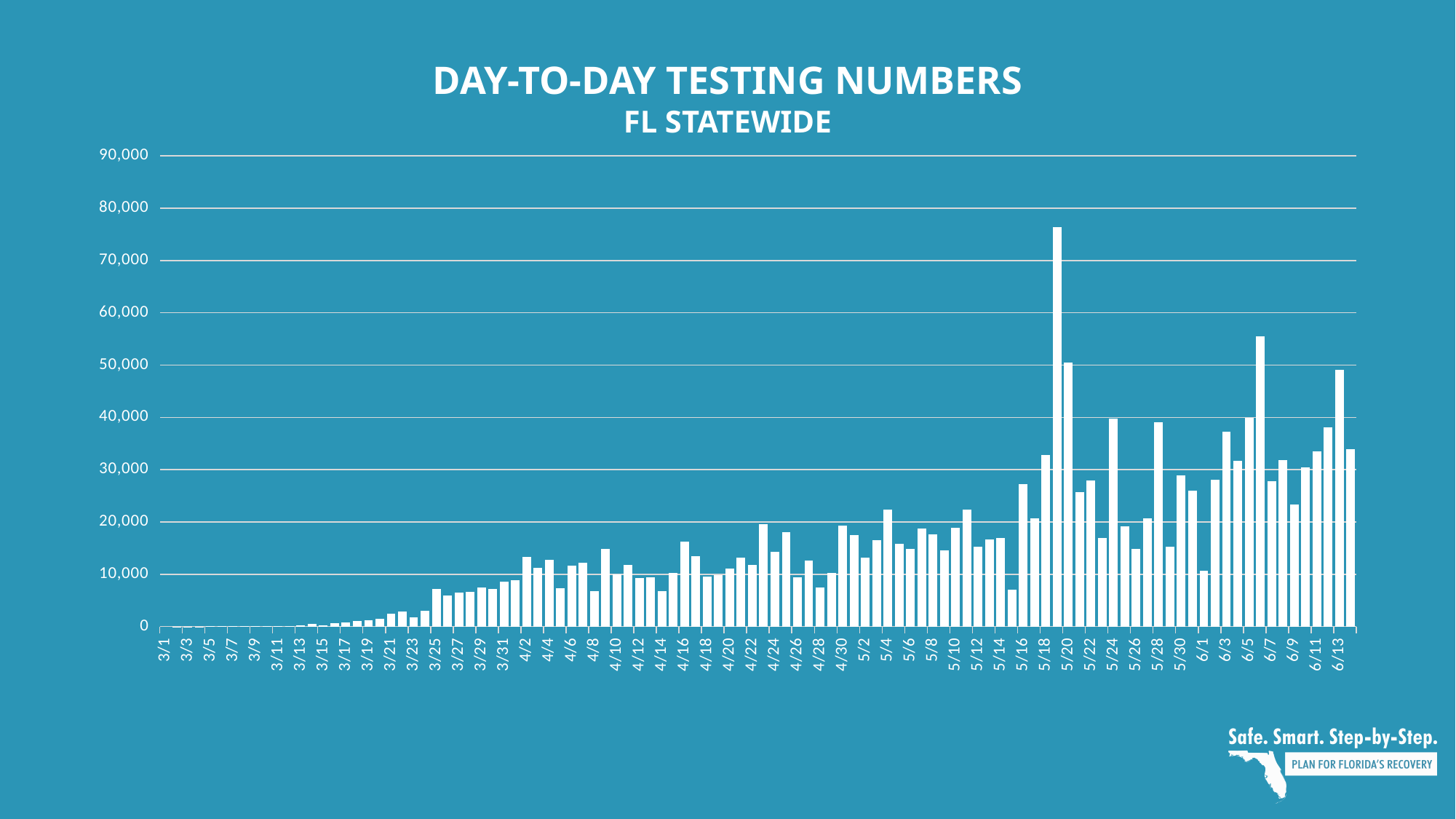
What is the highest value shown on the vertical axis? 90,000 What is the subtitle shown under the chart title? FL STATEWIDE In which month does the tallest bar on the chart occur? May Is the value for 4/2 greater or less than 10,000? greater Is the value for 3/1 greater or less than 10,000? less What kind of chart is shown on the slide? bar chart Which date has the larger value, 5/16 or 4/2? 5/16 What is the title of the chart? DAY-TO-DAY TESTING NUMBERS Overall, do the testing numbers rise or fall from March to June? rise